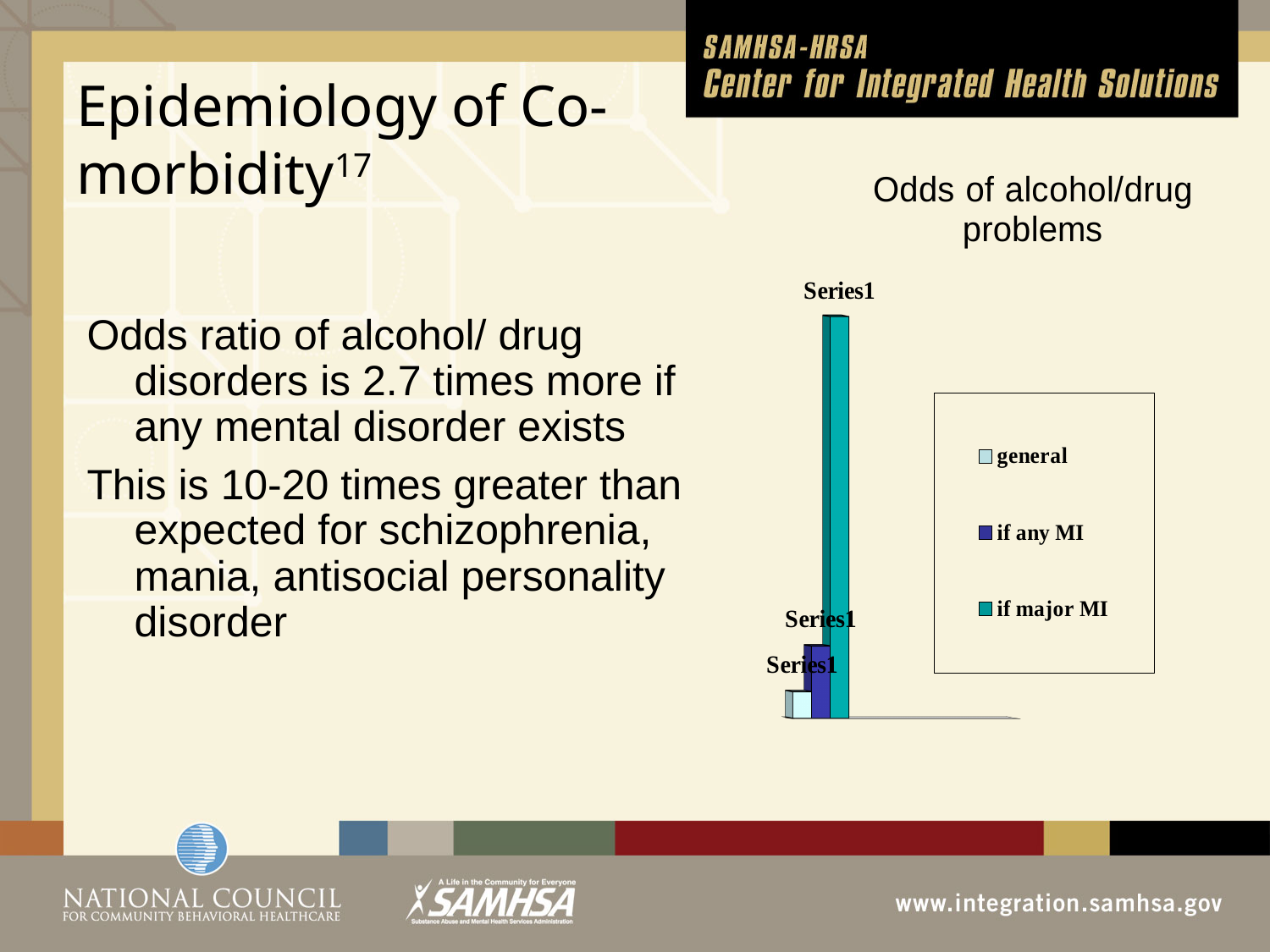
What text label appears above each bar in the chart? Series1 How many entries does the chart's legend list? 3 Which bar is taller, 'if major MI' or 'if any MI'? if major MI What colour is the bar for 'if major MI' in the chart? teal Which legend entry has the shortest bar in the chart? general Which bar is taller, 'if any MI' or 'general'? if any MI What kind of chart is shown on the slide? bar chart What is the title of the chart on the slide? Odds of alcohol/drug problems Which legend entry has the tallest bar in the chart? if major MI How many bars are plotted in the chart? 3